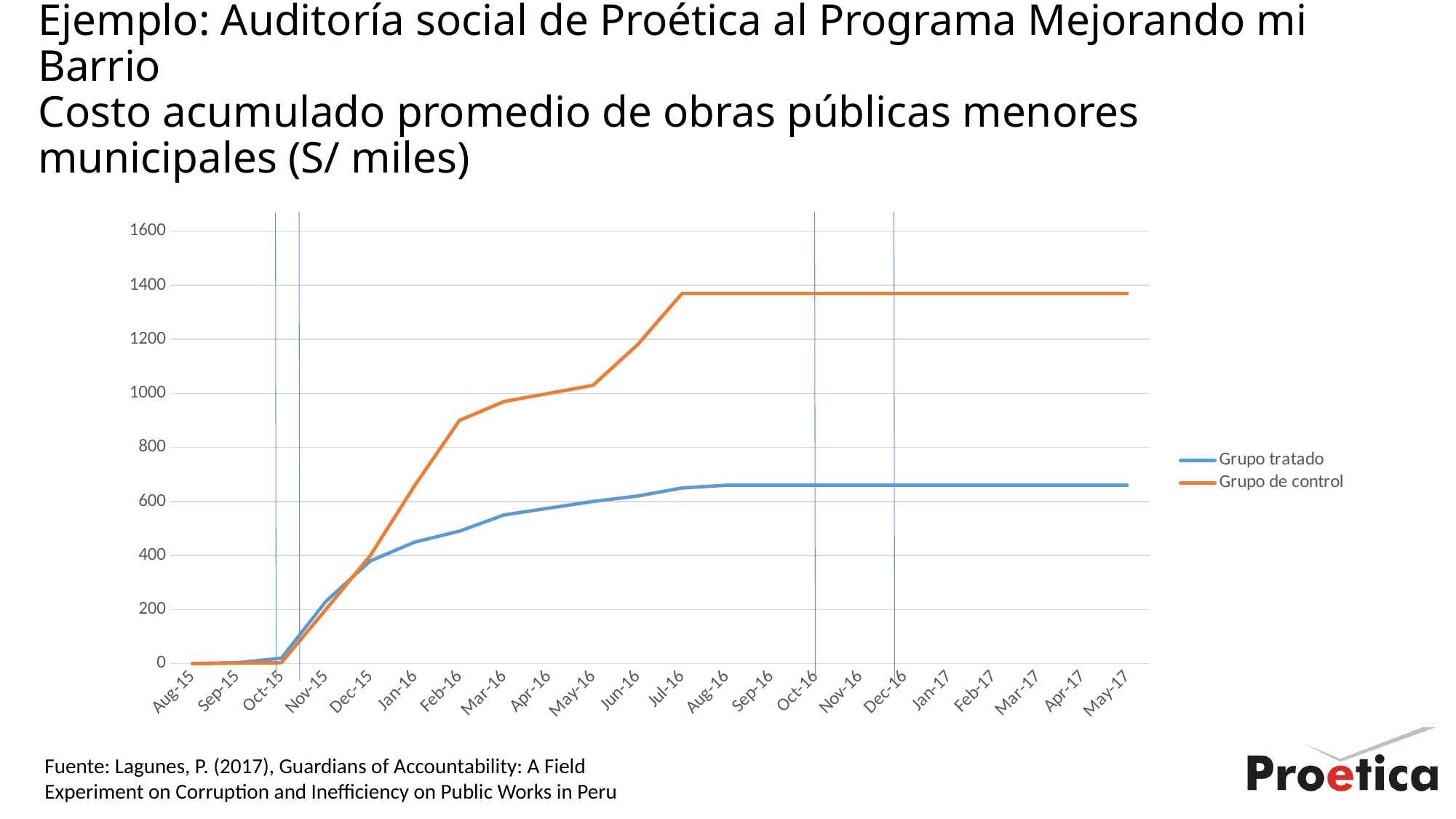
Which series is drawn in orange? Grupo de control Is the value for Grupo tratado at Feb-16 greater or less than 600? less What kind of chart is shown on the slide? line chart What is the first month shown on the x axis? Aug-15 Is the value for Grupo de control at Jul-16 greater or less than 1200? greater How many series does the legend list? 2 Which series is higher at May-17, Grupo tratado or Grupo de control? Grupo de control Is the value for Grupo de control at May-17 greater or less than 1200? greater Do the values for Grupo de control rise or fall from Aug-15 to Jul-16? rise How many months are shown along the x axis? 22